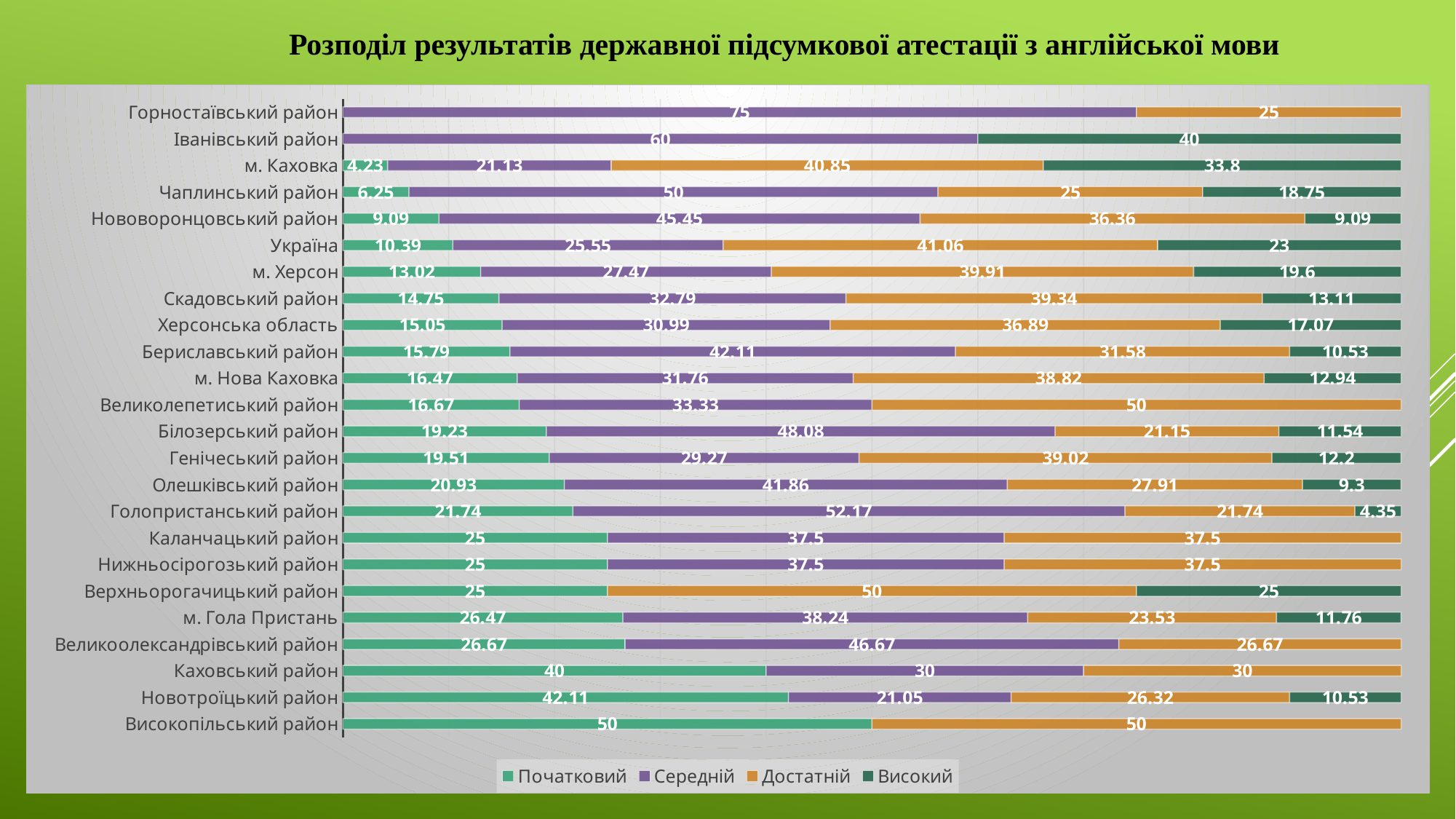
What is the value of the Достатній series for Україна? 41.06 What is the title of the chart? Розподіл результатів державної підсумкової атестації з англійської мови Which category has the highest value in the Середній series? Горностаївський район What kind of chart is shown on the slide? Stacked bar chart How many series does the legend list? 4 What is the value of the Початковий series for м. Херсон? 13.02 What is the total of the stacked bar for Високопільський район? 100 What is the value of the Високий series for Іванівський район? 40 How many categories (regions) are plotted on the chart? 24 What is the difference between the Достатній and Початковий values for Україна? 30.67 Which category has the highest value in the Високий series? Іванівський район For Скадовський район, which is larger: the Середній value or the Достатній value? Достатній